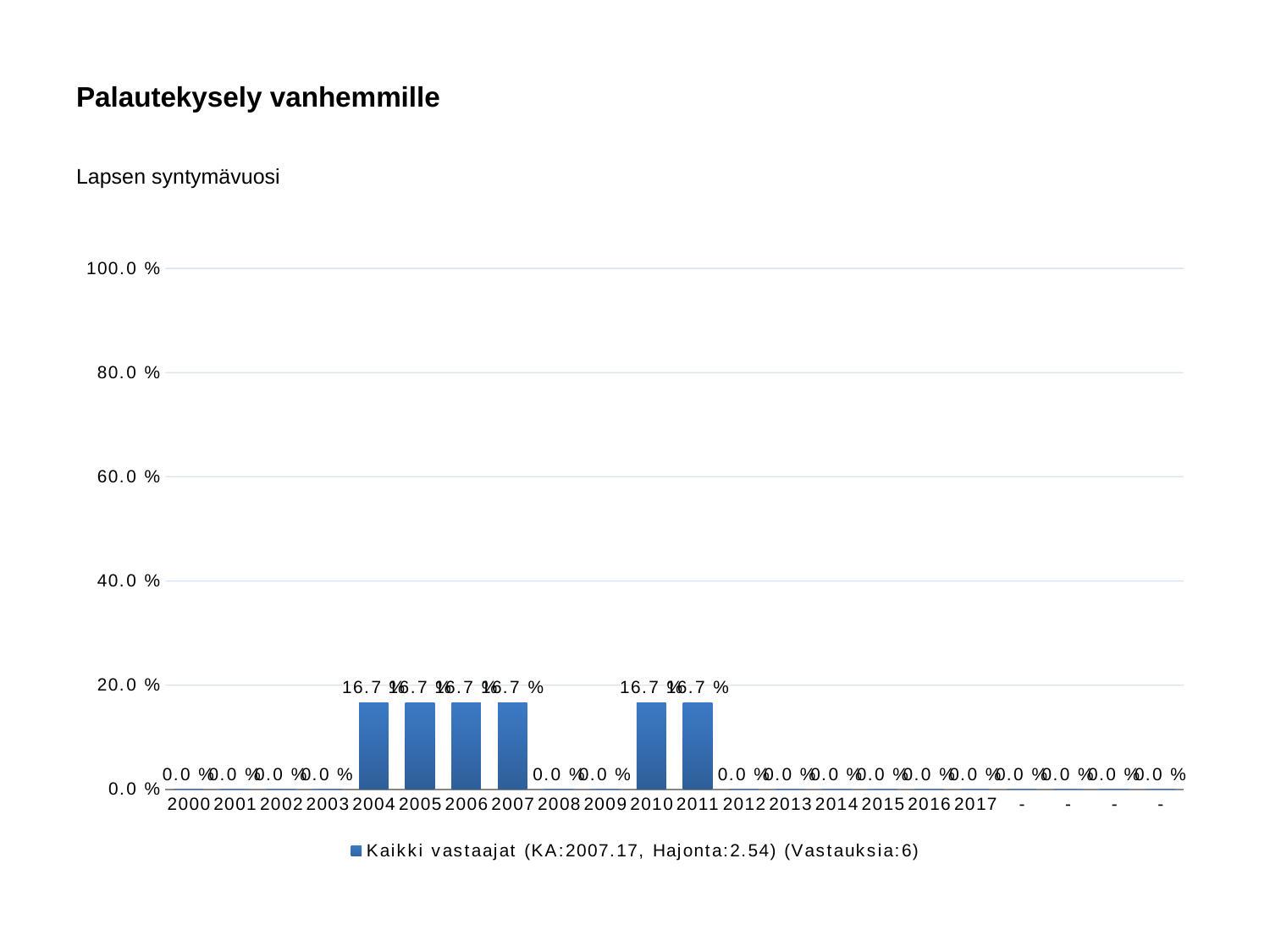
What is the value for 2015? 0.0 % What is the difference between the value for 2005 and the value for 2009? 16.7 % What is the subtitle of the chart shown below the slide title? Lapsen syntymävuosi What is the highest value shown in the chart? 16.7 % How many series does the legend list? 1 What type of chart is shown on the slide? bar chart Which is larger, the value for 2010 or the value for 2012? 2010 What is the value for 2004? 16.7 % What is the value for 2011? 16.7 % Is the value for 2006 greater or less than 20.0 %? less What is the value for 2008? 0.0 % How many categories have a value of 16.7 %? 6